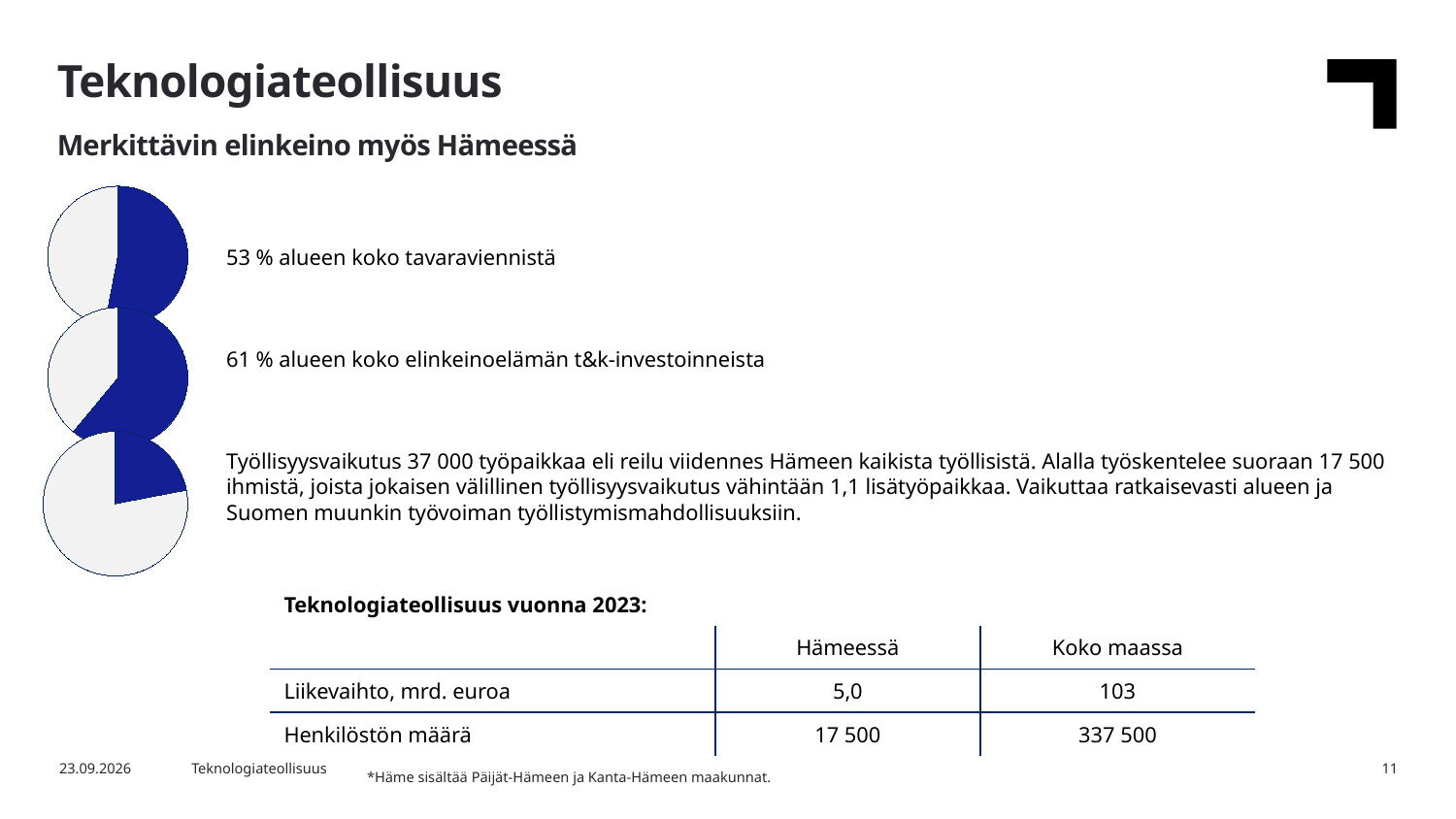
What kind of charts are shown on the left side of the slide? Pie charts In the top pie chart, what share does the blue slice represent (share of the region's total goods exports)? 53 % Which of the three pie charts has the smallest blue slice? The bottom pie chart In the middle pie chart, what share does the blue slice represent (share of the region's business R&D investments)? 61 % Is the blue slice in the bottom pie chart greater or less than 50 %? less Which of the three pie charts has the largest blue slice? The middle pie chart How many pie charts are on the slide? 3 Which blue slice is larger: the one in the top pie chart or the one in the middle pie chart? The middle pie chart What is the difference between the blue share in the middle pie chart (61 %) and the blue share in the top pie chart (53 %)? 8 percentage points What colour is the highlighted slice in each pie chart? Dark blue How many slices does each pie chart on the slide have? 2 Is the blue slice in the middle pie chart greater or less than 50 %? greater